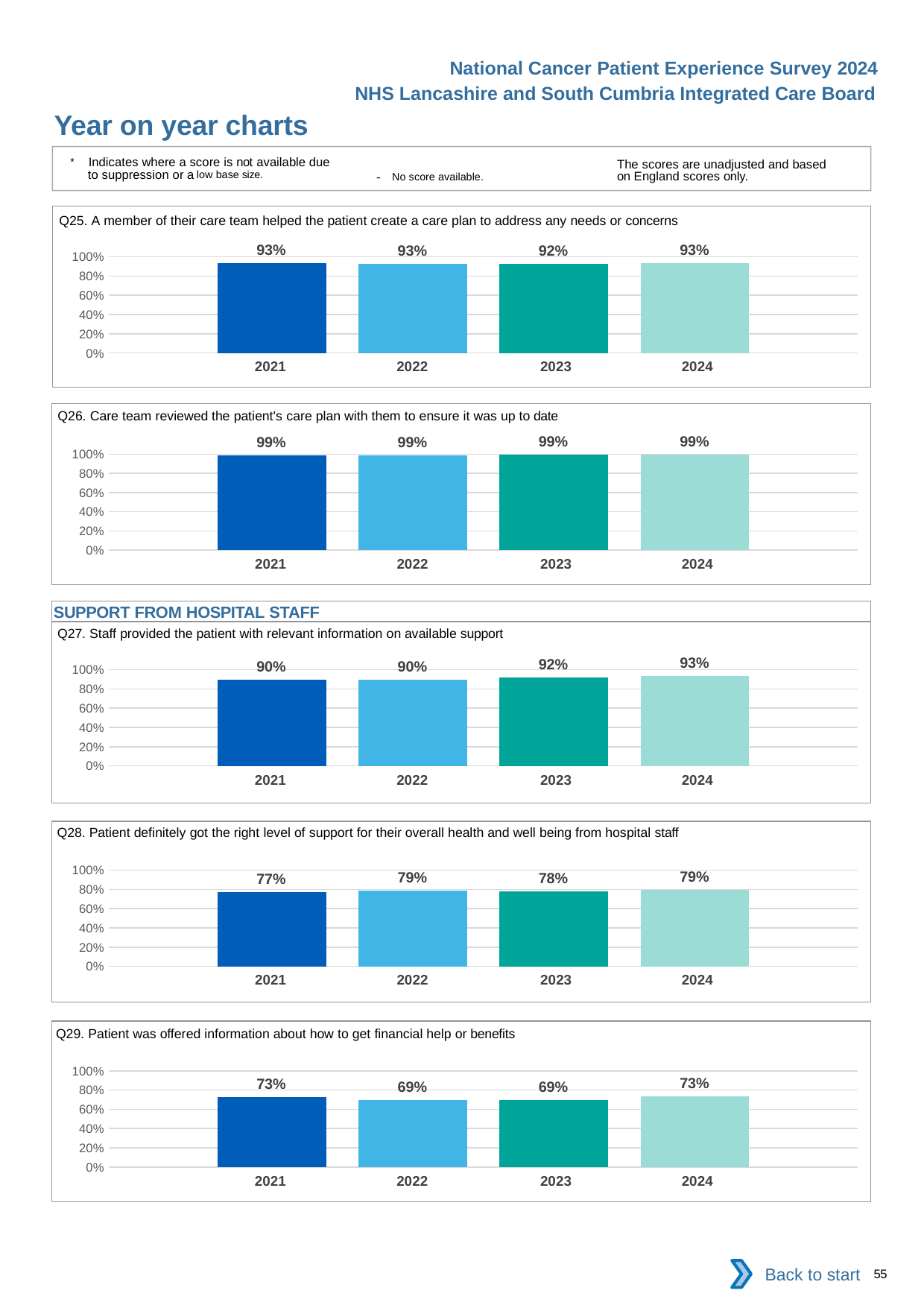
In the Q25 chart, what is the value for 2023? 92% In the Q28 chart, which year has the lowest value? 2021 In the Q29 chart, is the value for 2022 larger or smaller than the value for 2021? smaller In the Q27 chart, which year has the highest value? 2024 In the Q26 chart, what is the value for 2024? 99% In the Q29 chart, what is the difference between the 2021 and 2022 values? 4% How many years are shown on the x axis of the Q25 chart? 4 In the Q27 chart, what is the difference between the 2024 and 2021 values? 3% In the Q27 chart, do the values rise or fall from 2021 to 2024? rise In the Q28 chart, what is the value for 2022? 79% What kind of chart is the Q28 chart? bar chart In the Q29 chart, is the value for 2023 greater or less than 80%? less